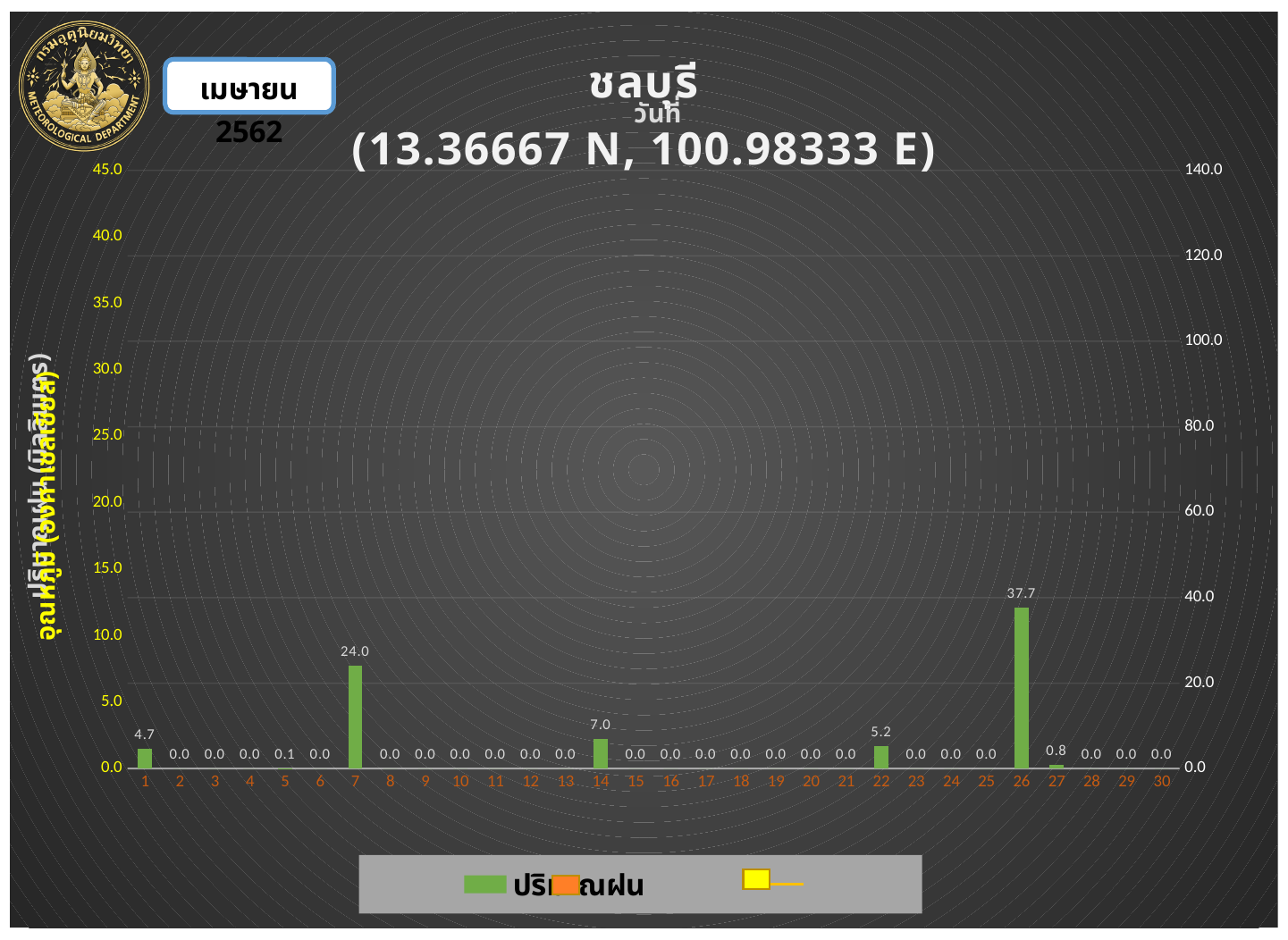
What is the rainfall value shown for day 27? 0.8 How many days are shown on the x axis of the chart? 30 What is the name of the station shown in the chart title? ชลบุรี What is the difference between the rainfall values for day 14 and day 22? 1.8 Which day has the highest rainfall value? 26 What is the rainfall value shown for day 14? 7.0 What is the rainfall value shown for day 26? 37.7 What is the rainfall value shown for day 7? 24.0 What kind of chart is used to show the rainfall values? bar chart What is the rainfall value shown for day 1? 4.7 Which has a larger rainfall value, day 1 or day 22? day 22 What is the difference between the rainfall values for day 26 and day 7? 13.7